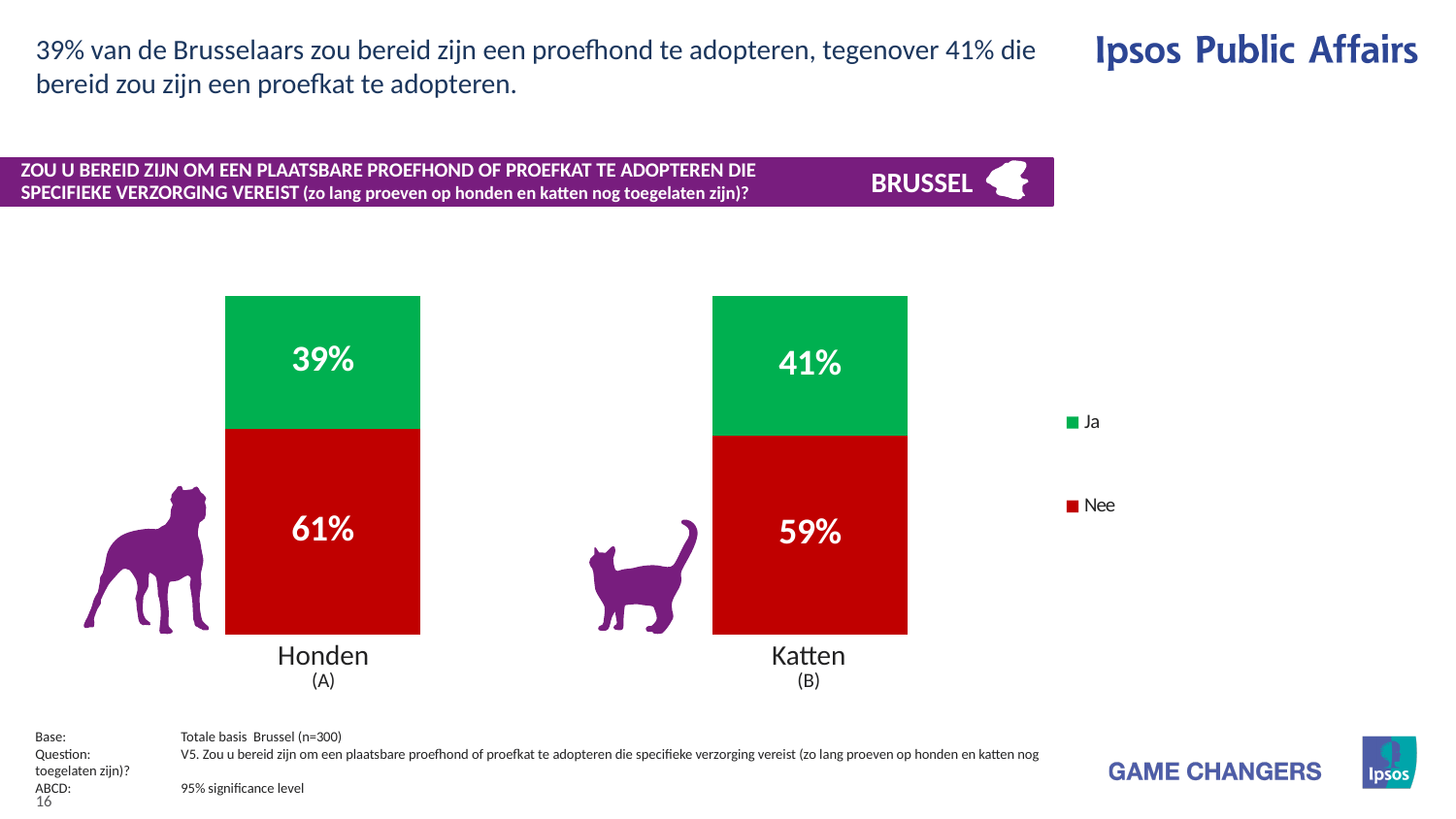
Which colour represents "Nee" in the legend? Red What is the total of the stacked bar for Honden? 100% Which category has the higher "Nee" share? Honden Which category has the higher "Ja" share, Honden or Katten? Katten What is the "Nee" value for Honden? 61% What percentage of respondents answered "Nee" for Katten? 59% What is the "Ja" value for Katten? 41% What percentage of respondents answered "Ja" for Honden? 39% How many categories are shown on the x axis? 2 How many series does the legend list? 2 What kind of chart is shown on the slide? Stacked bar chart What is the difference between the "Nee" values for Honden and Katten? 2%